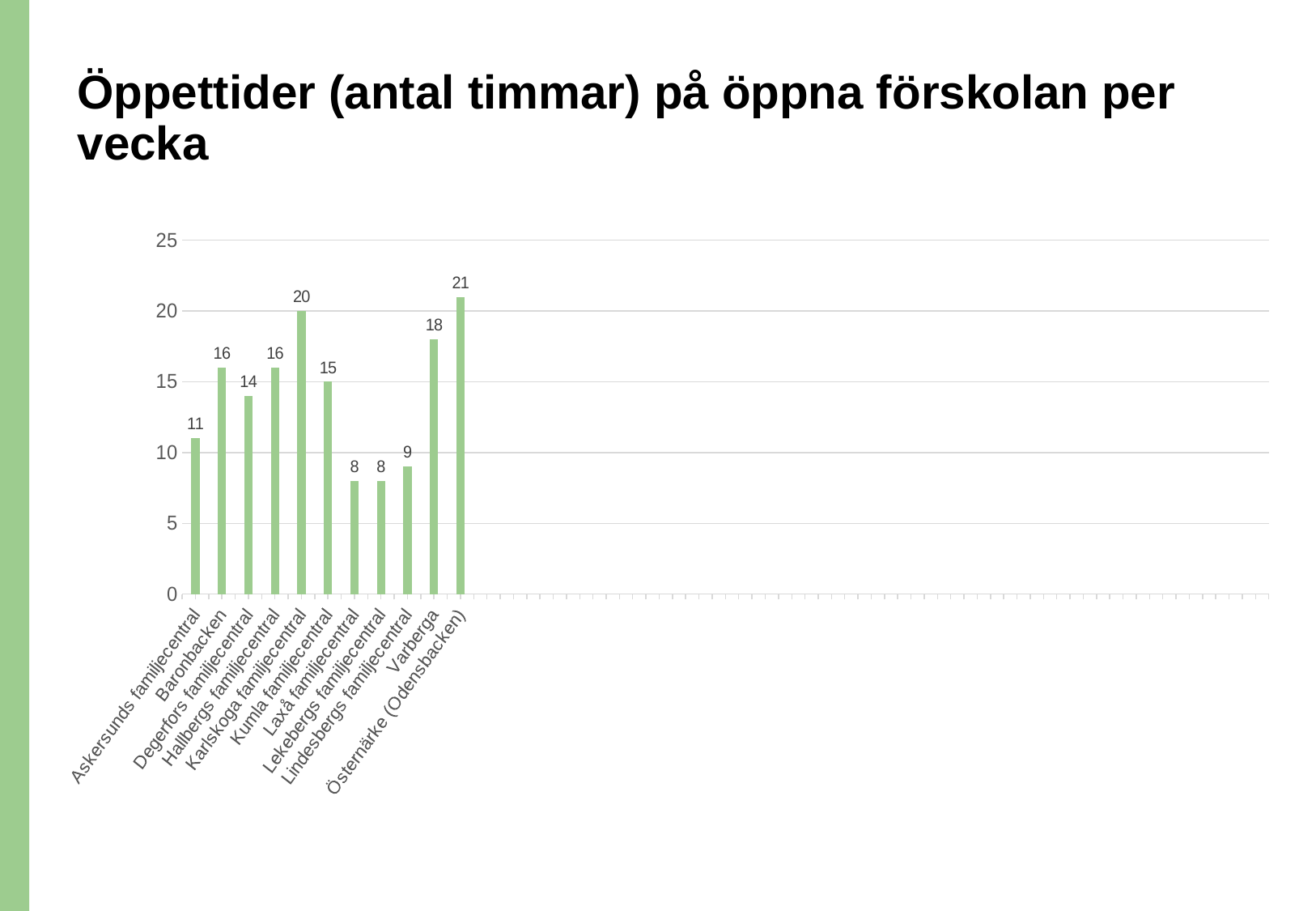
Is the value for Lindesbergs familjecentral greater or less than 10? less What is the value for Askersunds familjecentral? 11 Which category has the highest value? Östernärke (Odensbacken) What is the value for Karlskoga familjecentral? 20 What is the title of the slide? Öppettider (antal timmar) på öppna förskolan per vecka How many categories are shown on the x axis? 11 What is the difference between the values for Östernärke (Odensbacken) and Laxå familjecentral? 13 What is the difference between the values for Varberga and Baronbacken? 2 What is the value for Varberga? 18 What kind of chart is shown on the slide? bar chart What is the highest tick value shown on the y axis? 25 Which is larger, the value for Kumla familjecentral or the value for Degerfors familjecentral? Kumla familjecentral